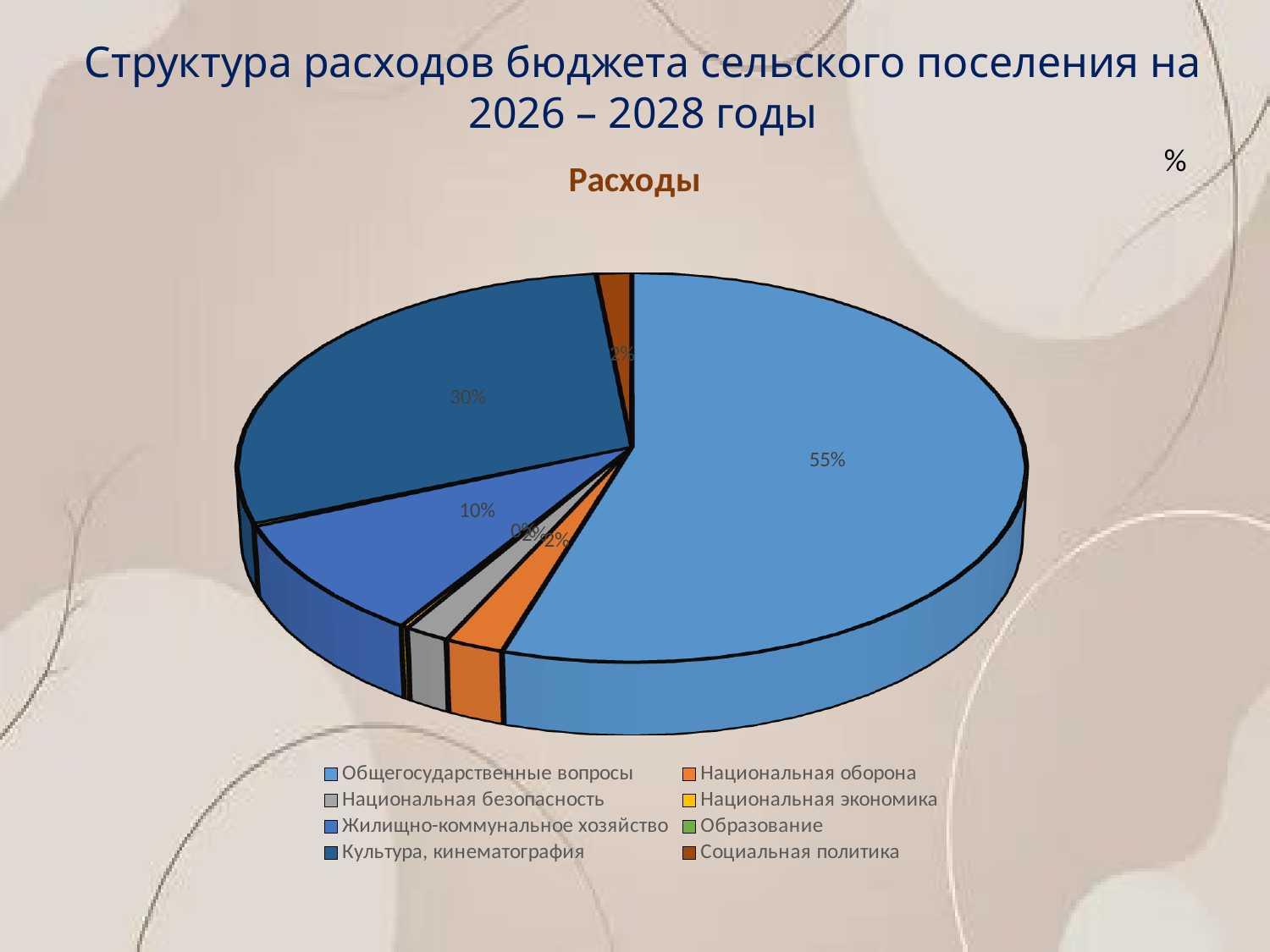
What kind of chart is shown on the slide? pie chart What is the title of the chart? Расходы Which is larger: Культура, кинематография or Жилищно-коммунальное хозяйство? Культура, кинематография What is the value for Социальная политика? 2% Which category has the largest share of the pie? Общегосударственные вопросы Which legend entry is shown in light blue? Общегосударственные вопросы What is the difference between the shares of Культура, кинематография and Жилищно-коммунальное хозяйство? 20% How many categories does the chart legend list? 8 What share of the pie is Общегосударственные вопросы? 55% What is the value for Культура, кинематография? 30% What is the value for Жилищно-коммунальное хозяйство? 10% What is the difference between the shares of Общегосударственные вопросы and Культура, кинематография? 25%